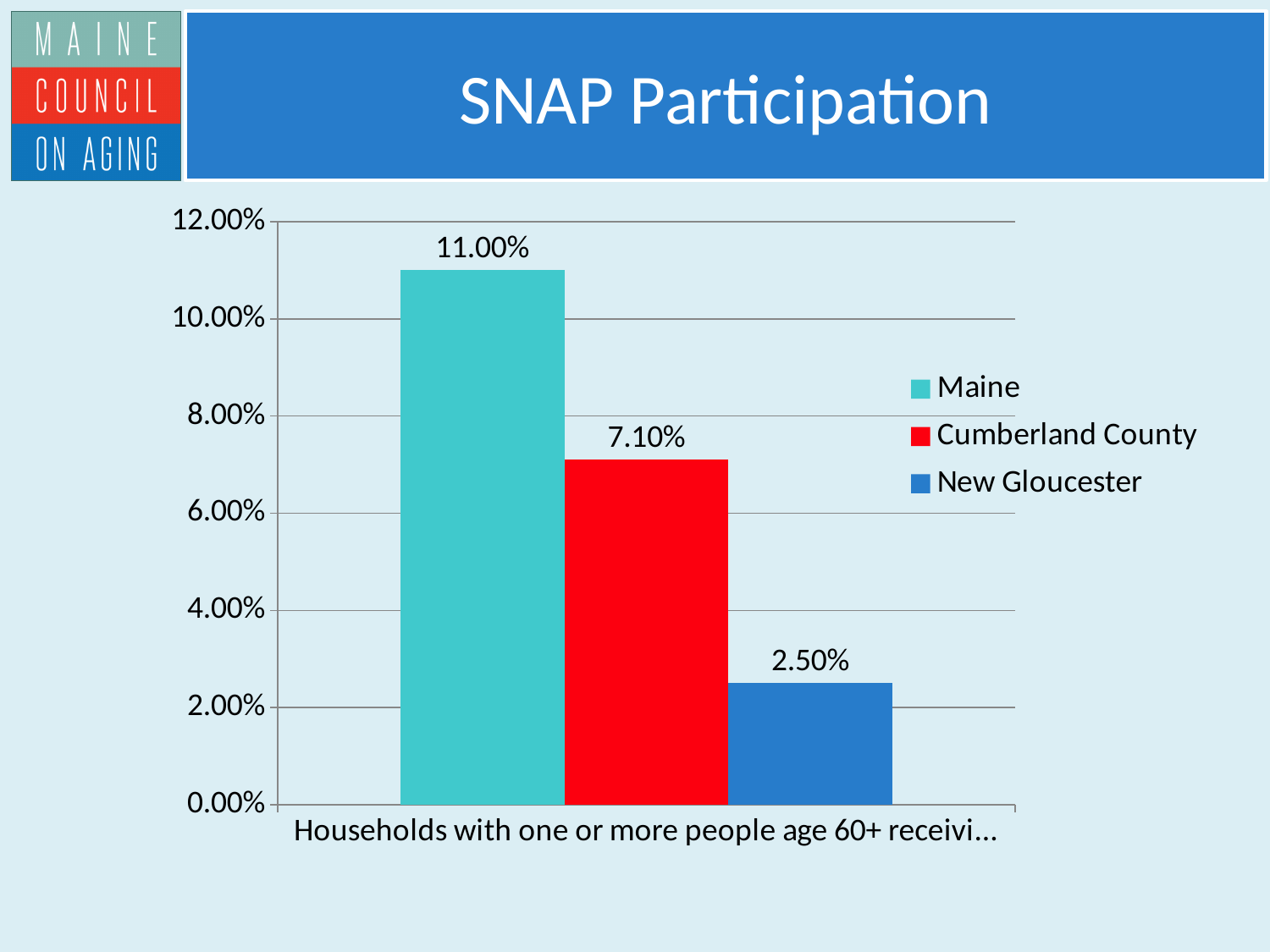
Which is larger, the value for Cumberland County or the value for New Gloucester? Cumberland County What is the difference between the values for Cumberland County and New Gloucester? 4.60% How many series does the legend list? 3 What is the value for Maine? 11.00% What kind of chart is shown on the slide? bar chart What is the value for Cumberland County? 7.10% Which series has the highest value? Maine Which series has the lowest value? New Gloucester Is the value for Maine greater or less than 10.00%? greater What is the value for New Gloucester? 2.50% What is the difference between the values for Maine and Cumberland County? 3.90% What is the title of the slide? SNAP Participation